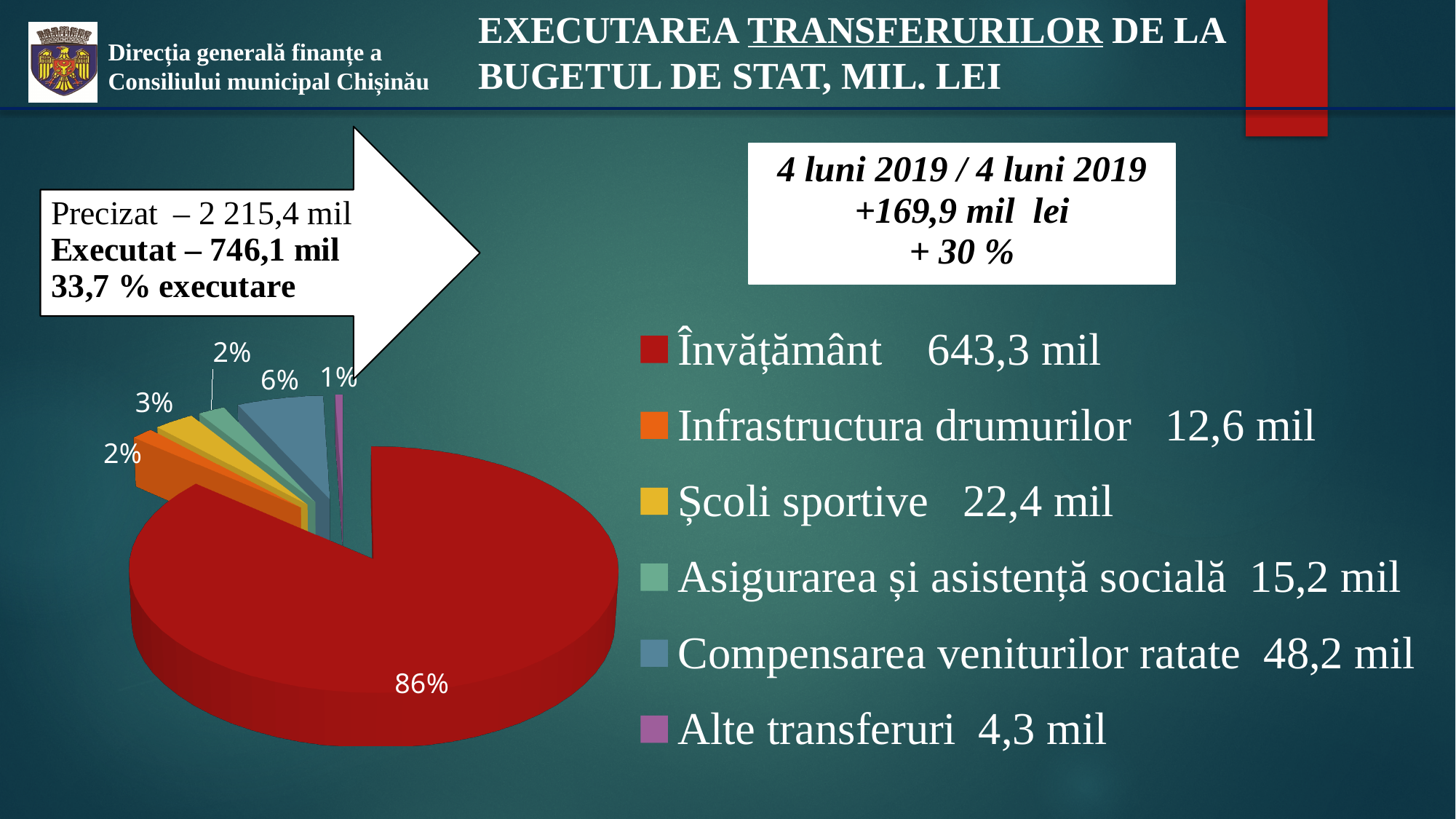
Which category has the largest slice of the pie chart? Învățământ Which category has the smallest slice of the pie chart? Alte transferuri What share of the pie does Învățământ represent? 86% How many slices does the pie chart have? 6 What share of the pie does Compensarea veniturilor ratate represent? 6% What share of the pie does Școli sportive represent? 3% What colour is the slice for Învățământ in the pie chart? red What is the value shown for Asigurarea și asistență socială? 15,2 mil What is the difference between the value for Compensarea veniturilor ratate and the value for Școli sportive? 25,8 mil What kind of chart is shown on the slide? pie chart What is the value shown for Infrastructura drumurilor? 12,6 mil Which is larger, the value for Școli sportive or the value for Alte transferuri? Școli sportive